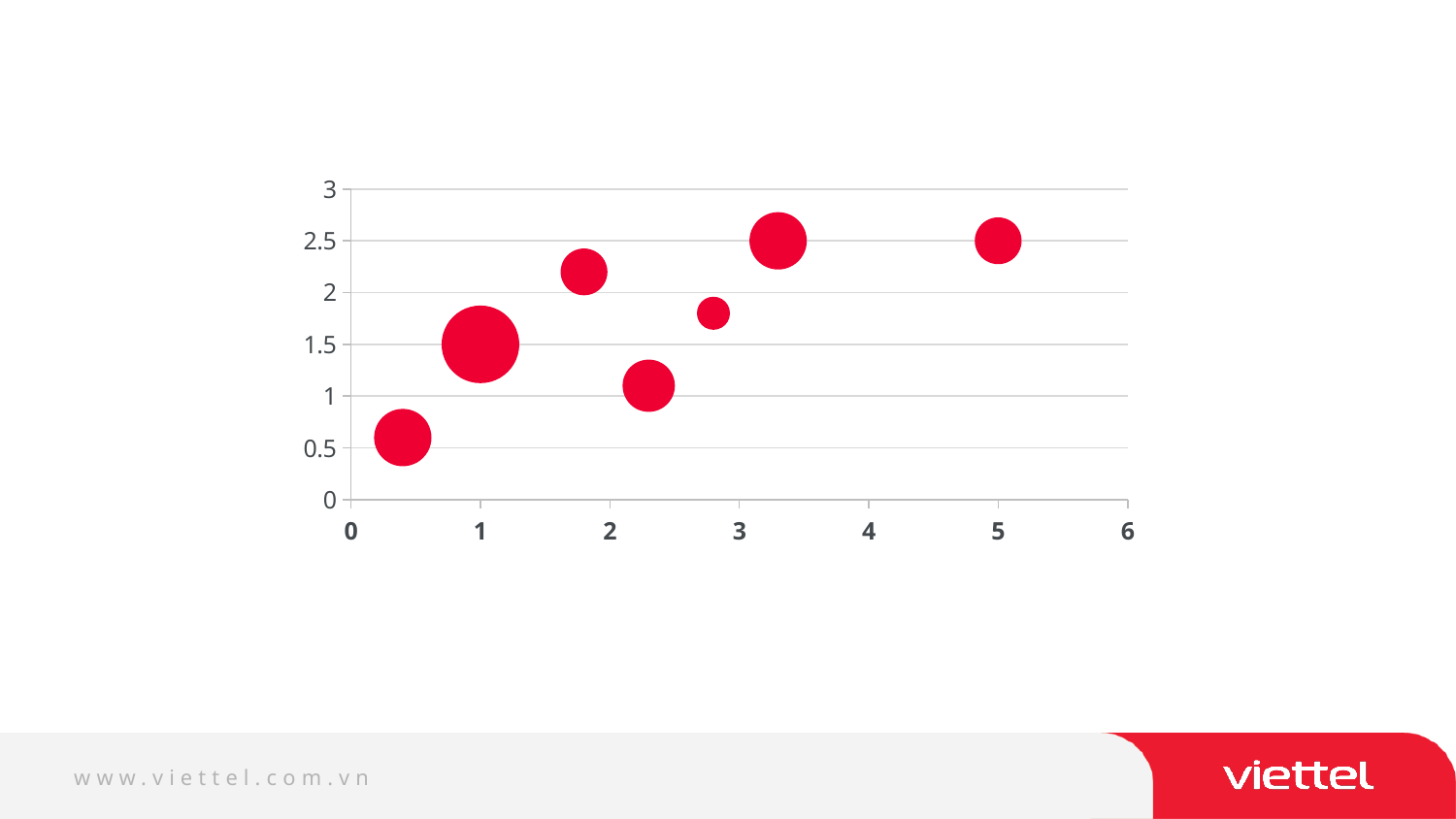
What colour are the bubbles on the chart? red Which bubble is the largest in size on the chart? the bubble at x = 1, y = 1.5 What is the y-axis value of the bubble located at x = 5? 2.5 Is the y value of the bubble near x = 1.8 greater or less than 2? greater Which bubble has the lowest y value: the one at x = 1 or the leftmost one near x = 0.4? the leftmost one near x = 0.4 Is the y value of the bubble near x = 2.3 greater or less than 1.5? less Do the y values of the bubbles generally rise or fall as x increases? rise How many bubbles are plotted on the chart? 7 Is the x value of the rightmost bubble greater or less than 4? greater What is the y-axis value of the bubble located at x = 1? 1.5 What kind of chart is shown on the slide? bubble chart